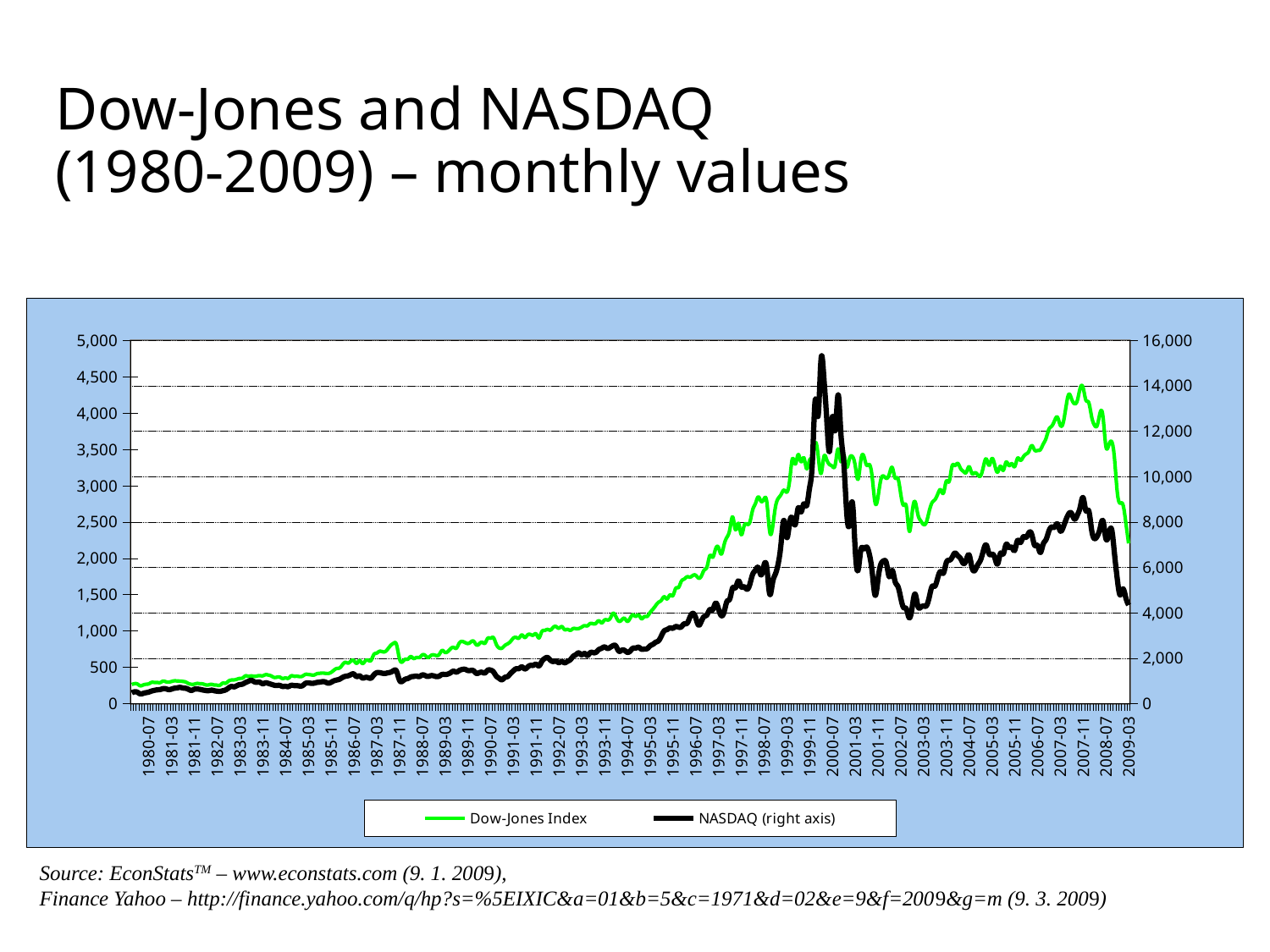
Which series shows the sharp spike around 2000? NASDAQ (right axis) What are the two series named in the legend? Dow-Jones Index and NASDAQ (right axis) How many series does the legend list? 2 What kind of chart is shown on the slide? Line chart Does the Dow-Jones Index line rise or fall from 2007-11 to 2009-03? Fall Does the NASDAQ line rise or fall from 2000-03 to 2002-07? Fall Does the NASDAQ line rise or fall from 2003-03 to 2007-11? Rise What colour is the line for the Dow-Jones Index? Green